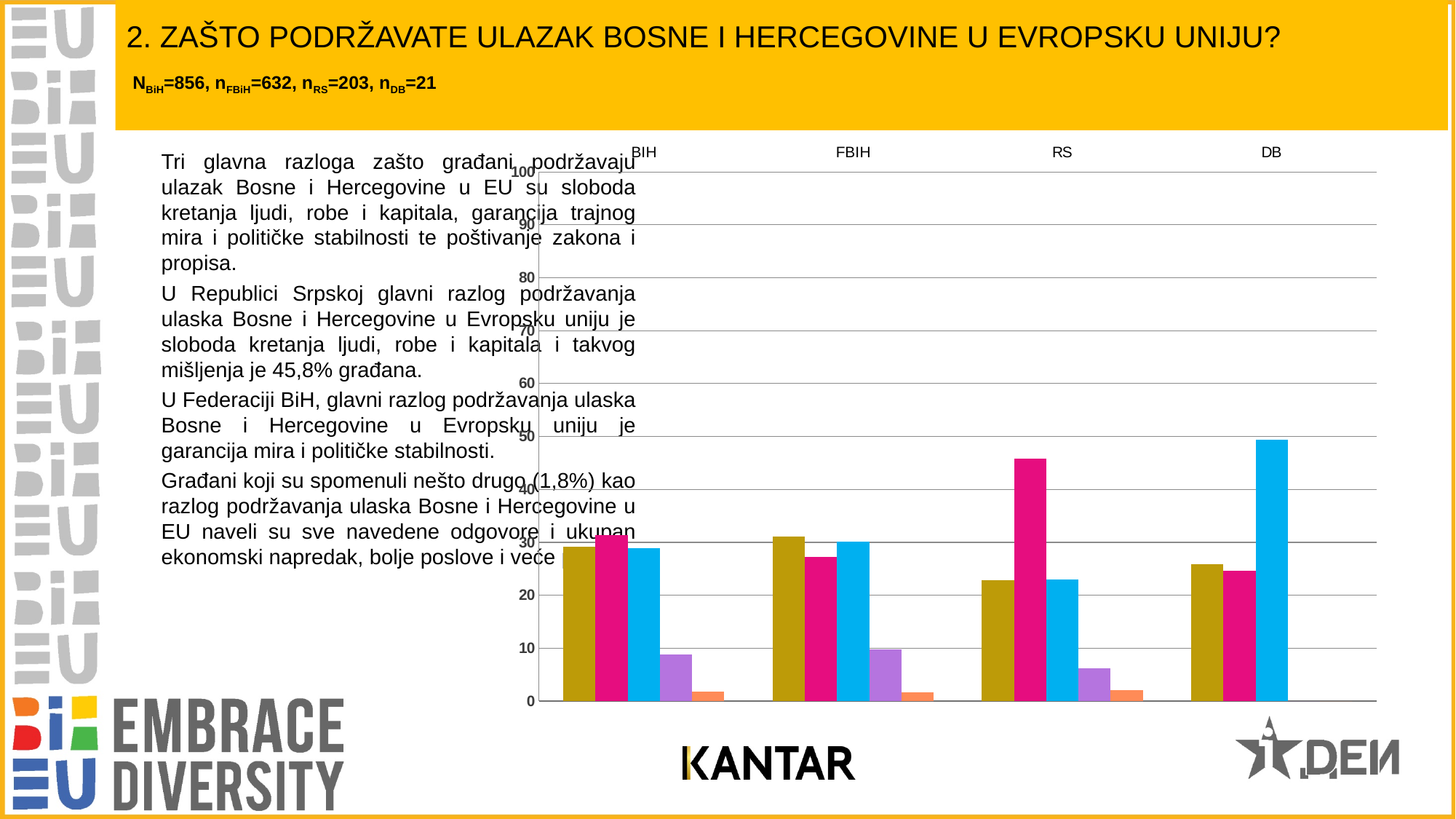
Is the value of the olive bar for FBIH greater or less than 20? greater Which group has the tallest blue bar? DB Is the value of the magenta bar for RS greater or less than 40? greater How many category groups are shown along the x axis of the chart? 4 Is the value of the blue bar for DB greater or less than 40? greater What is the highest value shown on the chart's vertical axis? 100 What kind of chart is shown on the slide? bar chart In the RS group, which bar is taller: the magenta bar or the olive bar? the magenta bar What are the four group labels shown above the chart? BIH, FBIH, RS, DB Which group has the tallest magenta bar? RS